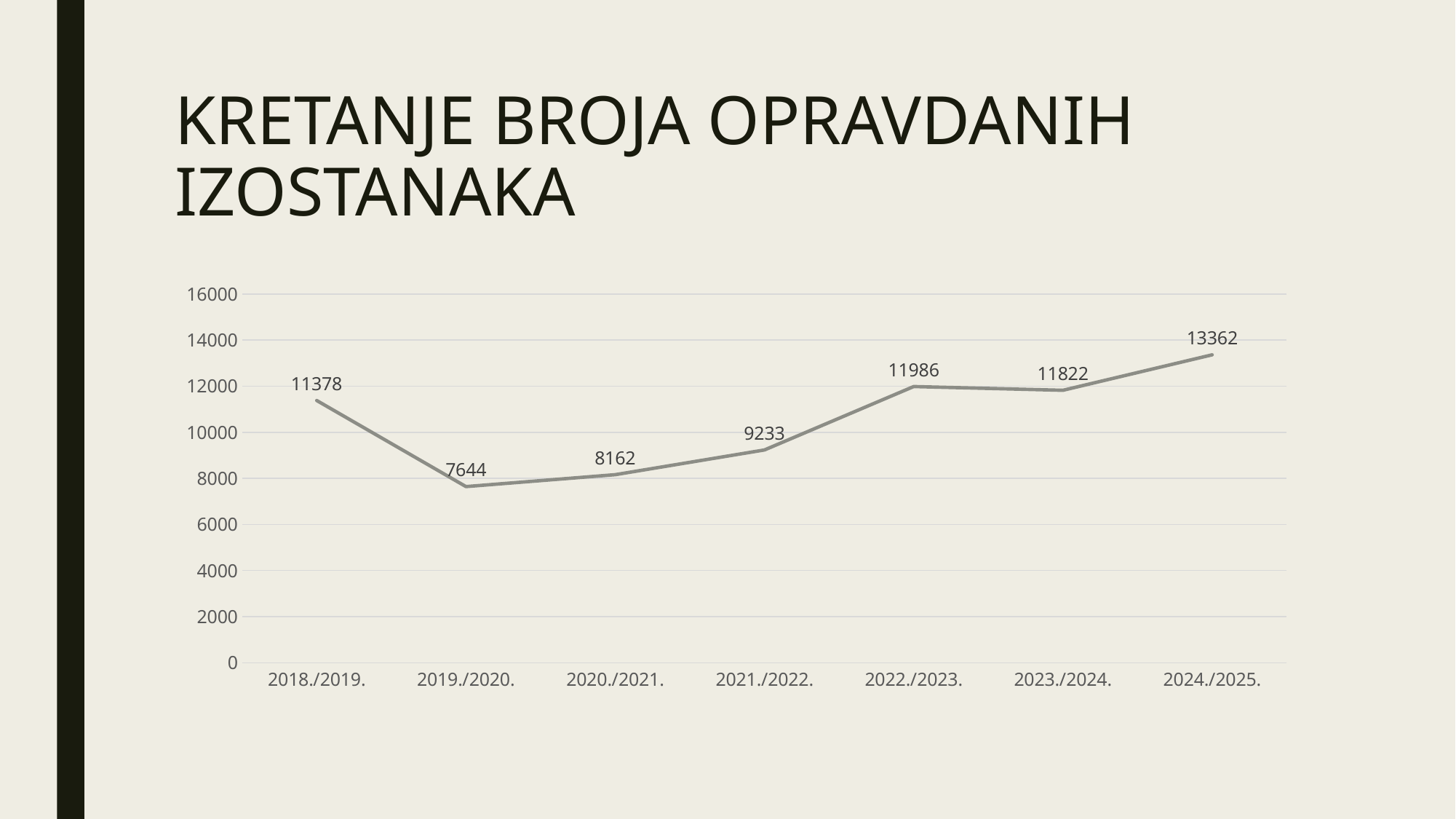
Does the value rise or fall from 2019./2020. to 2022./2023.? rise What is the value for 2018./2019.? 11378 Which school year has the highest value? 2024./2025. How many school years are plotted on the chart? 7 Which school year has the lowest value? 2019./2020. What is the value for 2021./2022.? 9233 Is the value for 2021./2022. greater or less than 10000? less What is the difference between the values for 2022./2023. and 2023./2024.? 164 What is the value for 2024./2025.? 13362 What is the difference between the values for 2024./2025. and 2019./2020.? 5718 What kind of chart is shown on the slide? line chart Which is larger, the value for 2018./2019. or the value for 2020./2021.? 2018./2019.